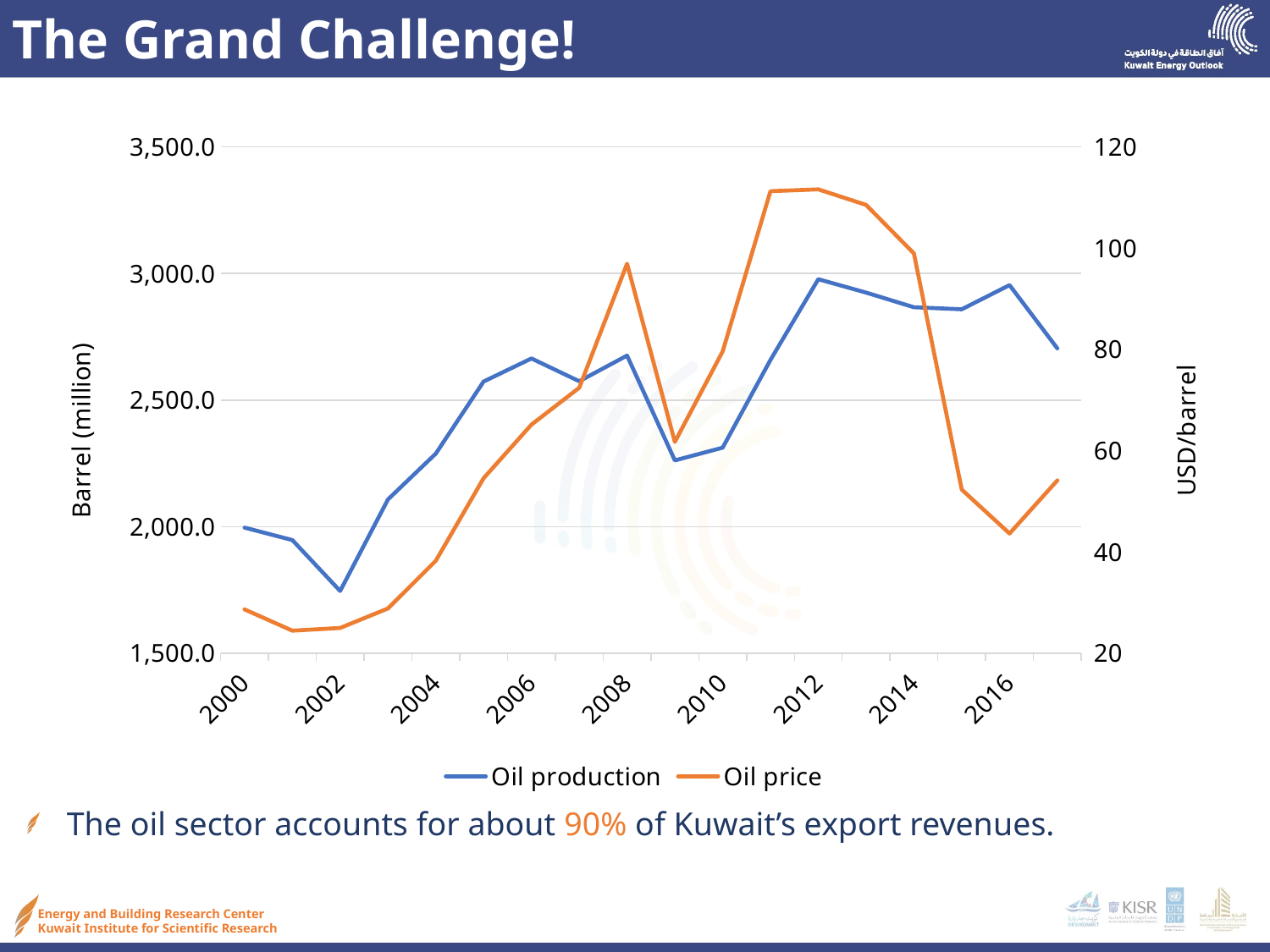
Is the value for Oil production in 2012 greater or less than 2,500.0? greater Is the value for Oil price in 2008 greater or less than 80? greater Which is larger, Oil production in 2008 or in 2009? 2008 What is the title of the right-hand vertical axis? USD/barrel What kind of chart is shown on the slide? Line chart Is the value for Oil price in 2016 greater or less than 60? less Which series is drawn in orange? Oil price Which is larger, Oil price in 2014 or in 2015? 2014 How many series does the legend list? 2 Does Oil price rise or fall between 2014 and 2016? Fall In which year is Oil production at its lowest? 2002